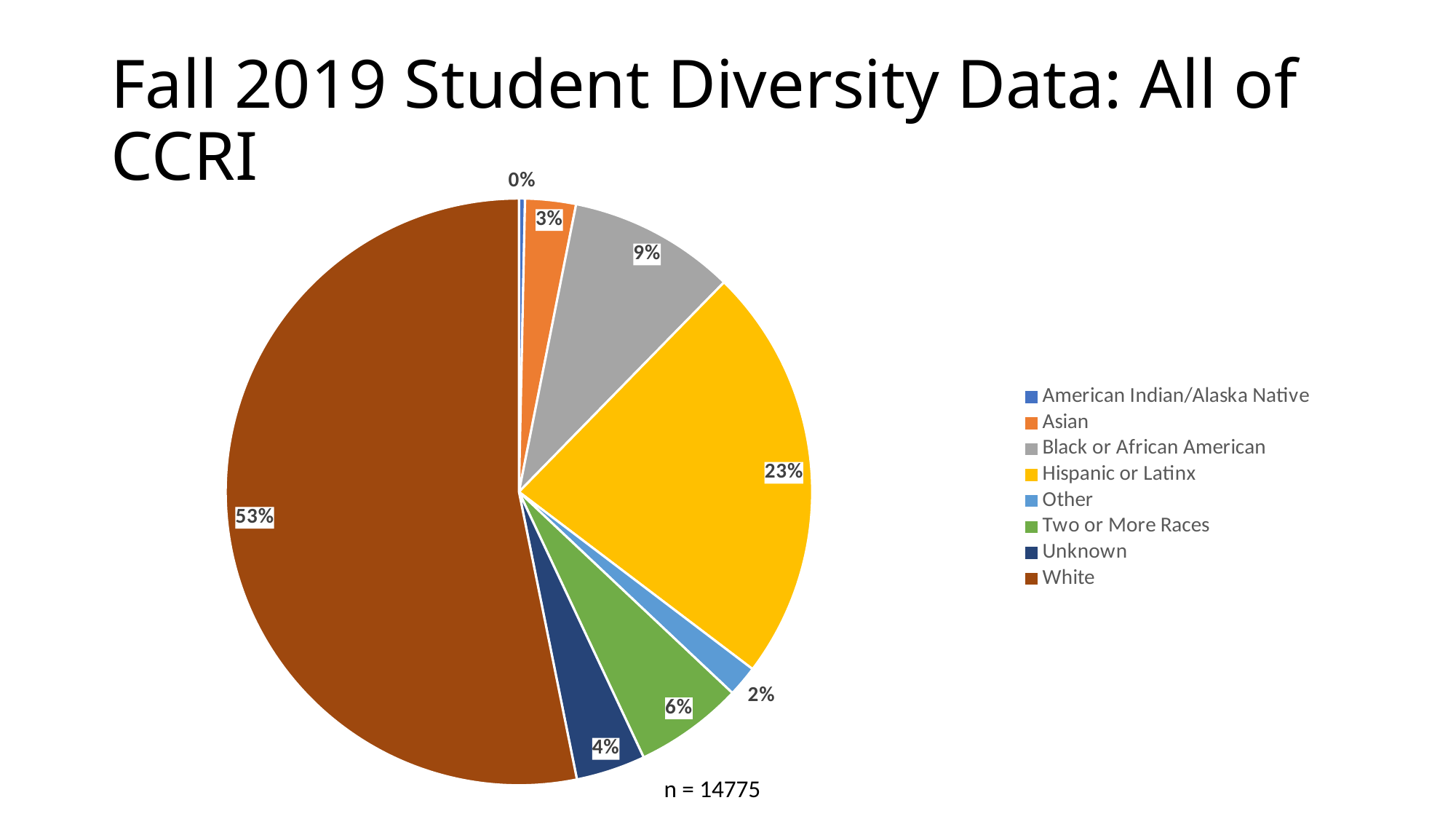
What kind of chart is shown on the slide? pie chart What percentage of students are in the Unknown category? 4% What percentage of students are Black or African American? 9% How many categories does the legend list? 8 What percentage of students are Asian? 3% What percentage of students are Two or More Races? 6% Which category has the largest share of the pie? White Which category has the smallest share of the pie? American Indian/Alaska Native What is the difference in percentage points between the White and Hispanic or Latinx shares? 30 What percentage of students are Hispanic or Latinx? 23% What percentage of students are White? 53% Which is larger, the share for Black or African American or the share for Two or More Races? Black or African American